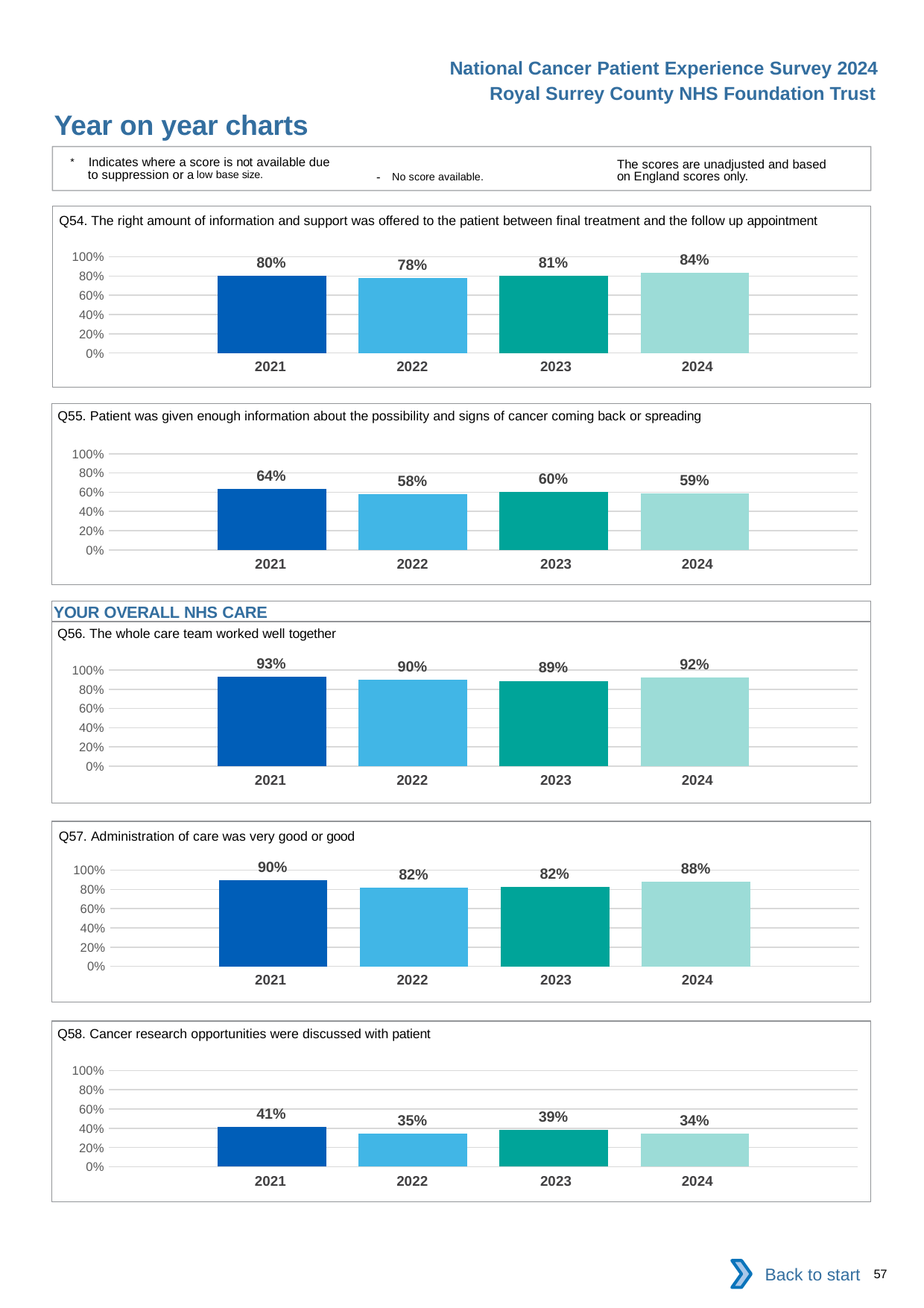
How many years are shown in the Q58 chart? 4 In the Q55 chart, what is the difference between the 2021 and 2022 values? 6% In the Q56 chart, what is the value for 2023? 89% What type of chart is the Q54 chart? Bar chart In the Q58 chart, what is the value for 2024? 34% In the Q54 chart, what is the value for 2024? 84% In the Q57 chart, what is the difference between the 2024 and 2023 values? 6% In the Q57 chart, is the value for 2021 larger than the value for 2022? Yes In the Q54 chart, which year has the lowest value? 2022 In the Q58 chart, which year has the highest value? 2021 In the Q55 chart, what is the value for 2021? 64% In the Q56 chart, which year has the highest value? 2021